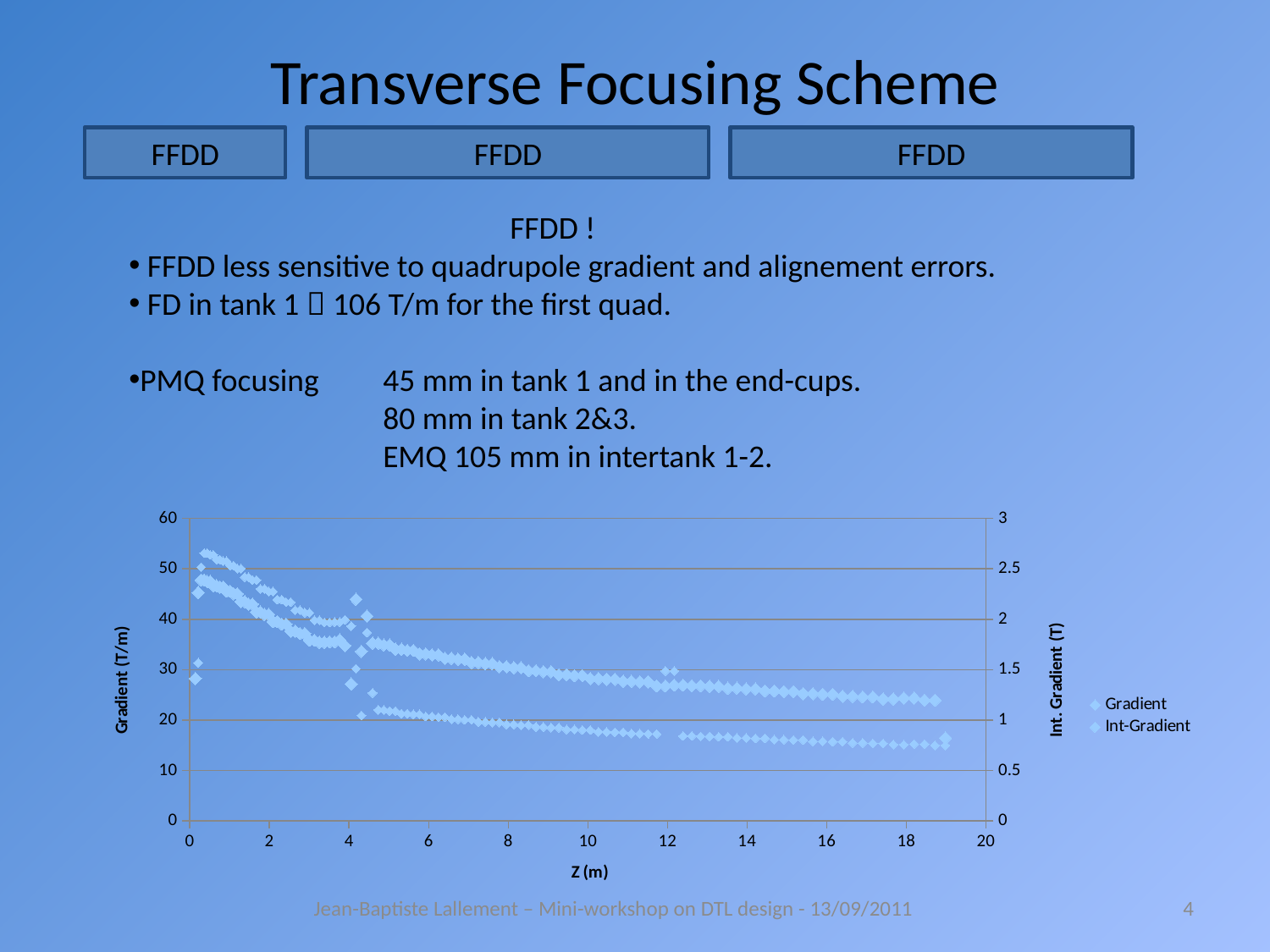
What kind of chart is shown on the slide? scatter chart Do the plotted values generally rise or fall as Z increases from 0 to 20 m? fall What is the title of the chart's horizontal axis? Z (m) Near Z = 1 m, is the highest plotted point greater or less than 40 on the left axis? greater What are the two series named in the chart legend? Gradient and Int-Gradient At Z = 18 m, are the plotted points greater or less than 40 on the left axis? less How many series does the chart legend list? 2